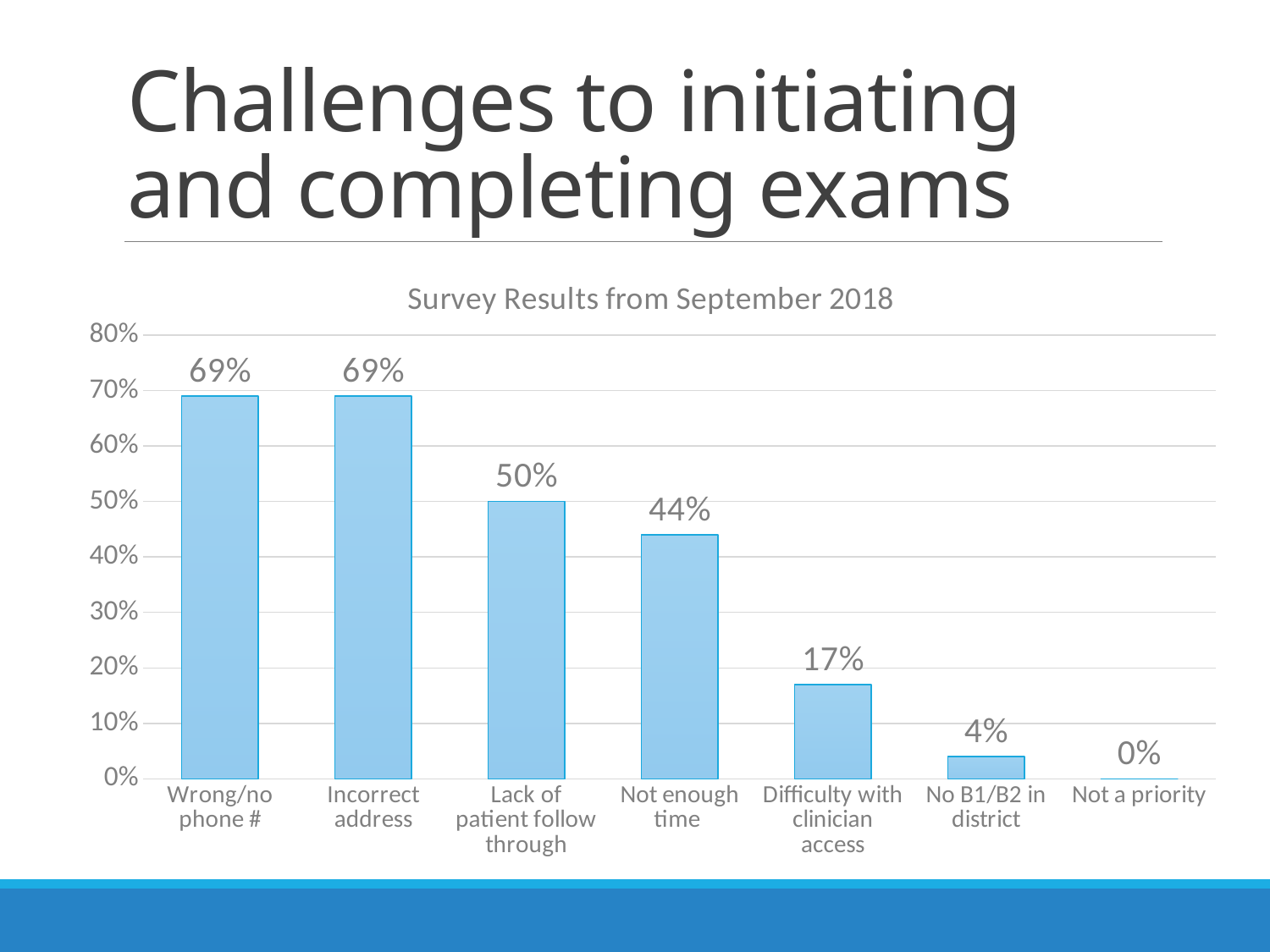
What is the value for Difficulty with clinician access? 17% Which is larger, the value for Not enough time or the value for Difficulty with clinician access? Not enough time Is the value for Wrong/no phone # greater or less than 60%? greater What is the value for Not enough time? 44% What kind of chart is shown on the slide? Bar chart What is the difference between the values for Lack of patient follow through and Difficulty with clinician access? 33% What is the value for No B1/B2 in district? 4% Which category has the lowest value? Not a priority How many categories are shown in the chart? 7 What is the title of the chart? Survey Results from September 2018 What is the difference between the values for Incorrect address and Not enough time? 25% What is the value for Lack of patient follow through? 50%